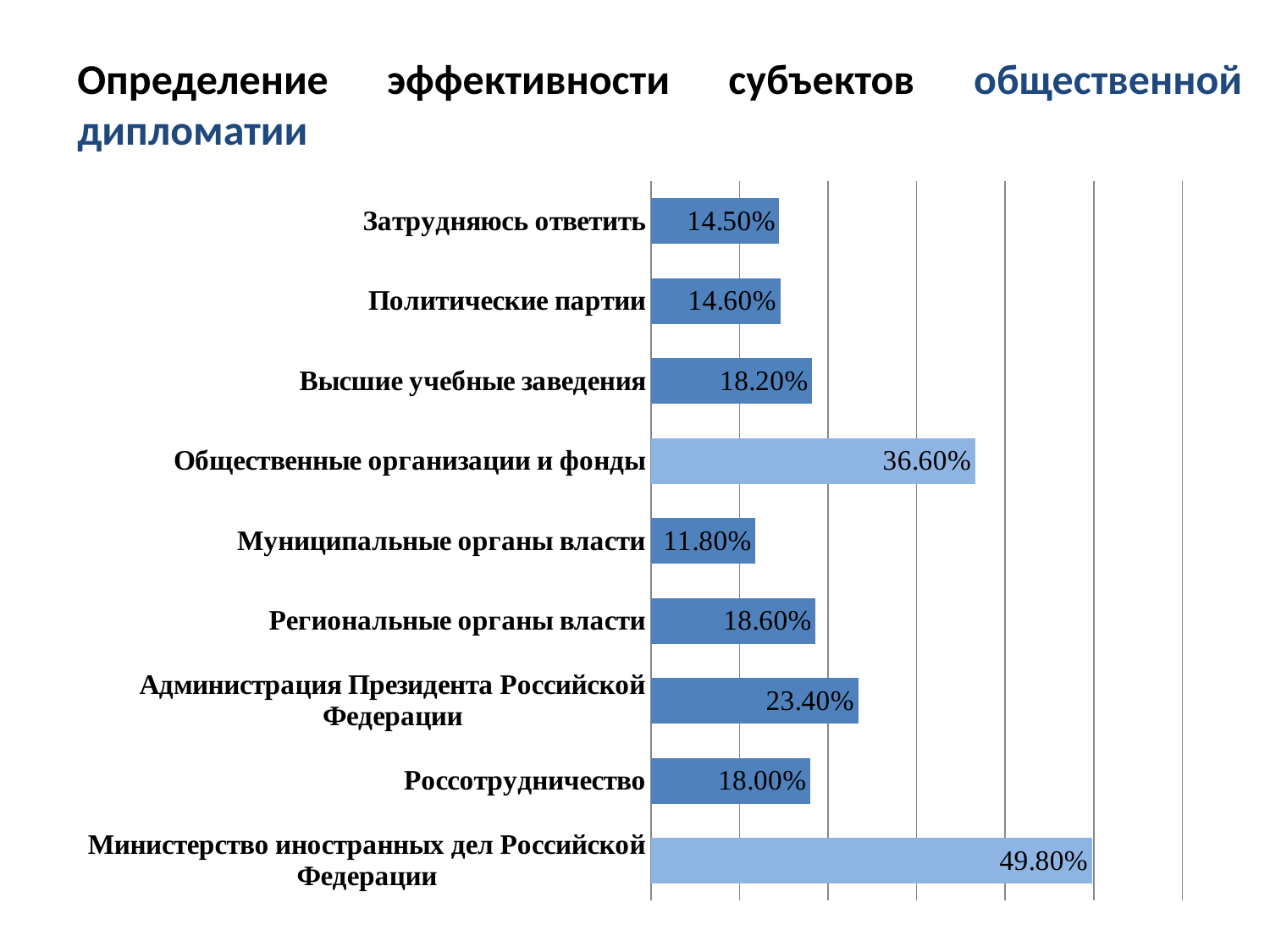
What is the value for Общественные организации и фонды? 36.60% What is the value for Администрация Президента Российской Федерации? 23.40% What is the value for Министерство иностранных дел Российской Федерации? 49.80% Which category has the lowest value? Муниципальные органы власти How many categories are plotted in the chart? 9 What kind of chart is shown on the slide? Bar chart What is the value for Муниципальные органы власти? 11.80% What is the difference between the values for Региональные органы власти and Муниципальные органы власти? 6.80% What is the difference between the values for Министерство иностранных дел Российской Федерации and Общественные организации и фонды? 13.20% What is the value for Затрудняюсь ответить? 14.50% Which category has the highest value? Министерство иностранных дел Российской Федерации Which is larger: the value for Администрация Президента Российской Федерации or the value for Россотрудничество? Администрация Президента Российской Федерации